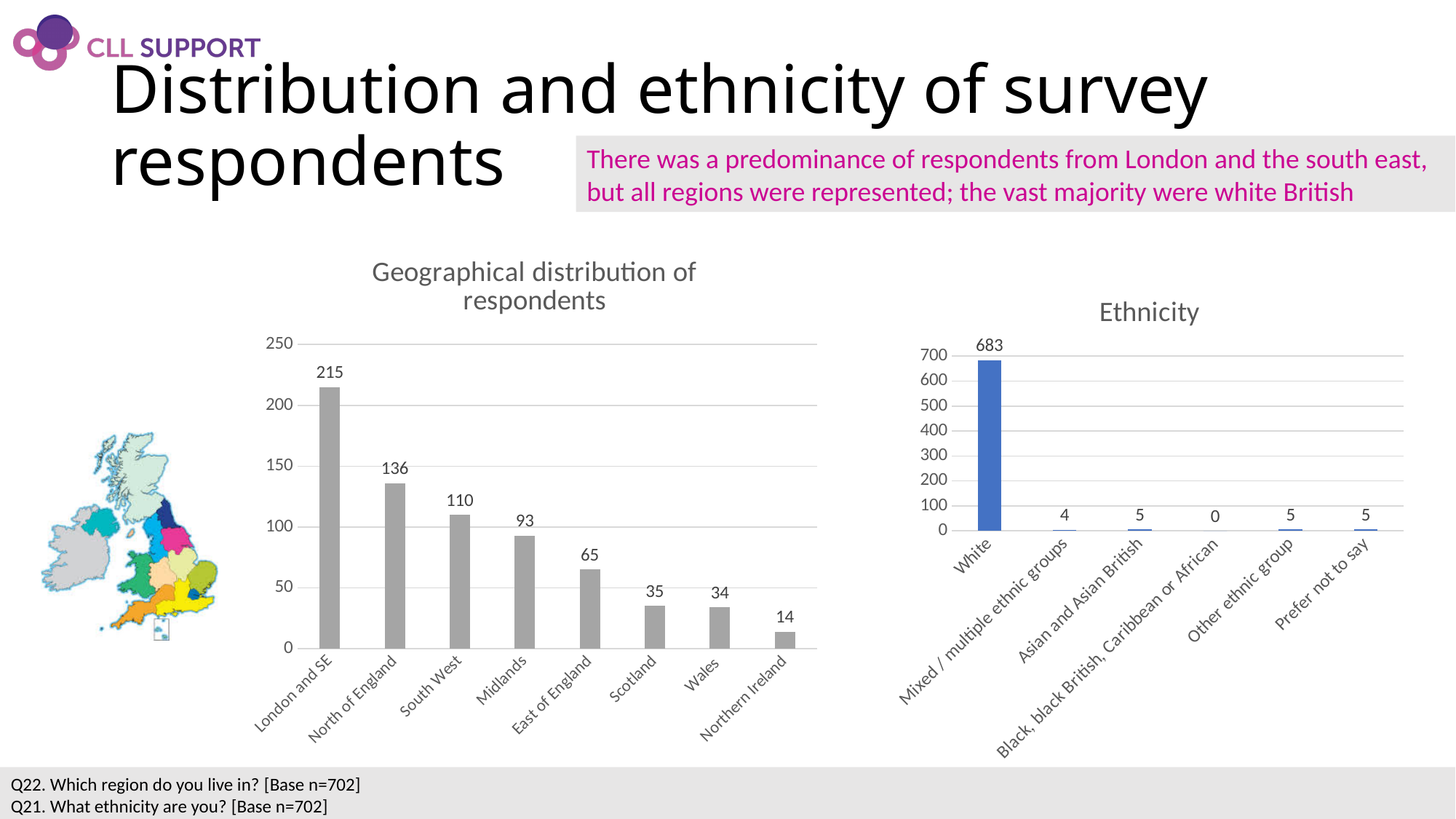
What type of chart is the 'Ethnicity' chart? bar chart In the 'Geographical distribution of respondents' chart, which region has the lowest value? Northern Ireland How many categories are shown in the 'Ethnicity' chart? 6 In the 'Geographical distribution of respondents' chart, which is larger, Midlands or East of England? Midlands In the 'Geographical distribution of respondents' chart, what is the value for London and SE? 215 In the 'Geographical distribution of respondents' chart, do the values rise or fall from left to right? fall In the 'Ethnicity' chart, what is the value for White? 683 How many regions are shown in the 'Geographical distribution of respondents' chart? 8 In the 'Geographical distribution of respondents' chart, what is the difference between North of England and South West? 26 In the 'Ethnicity' chart, which category has the highest value? White In the 'Ethnicity' chart, what is the value for Mixed / multiple ethnic groups? 4 In the 'Geographical distribution of respondents' chart, what is the value for Scotland? 35